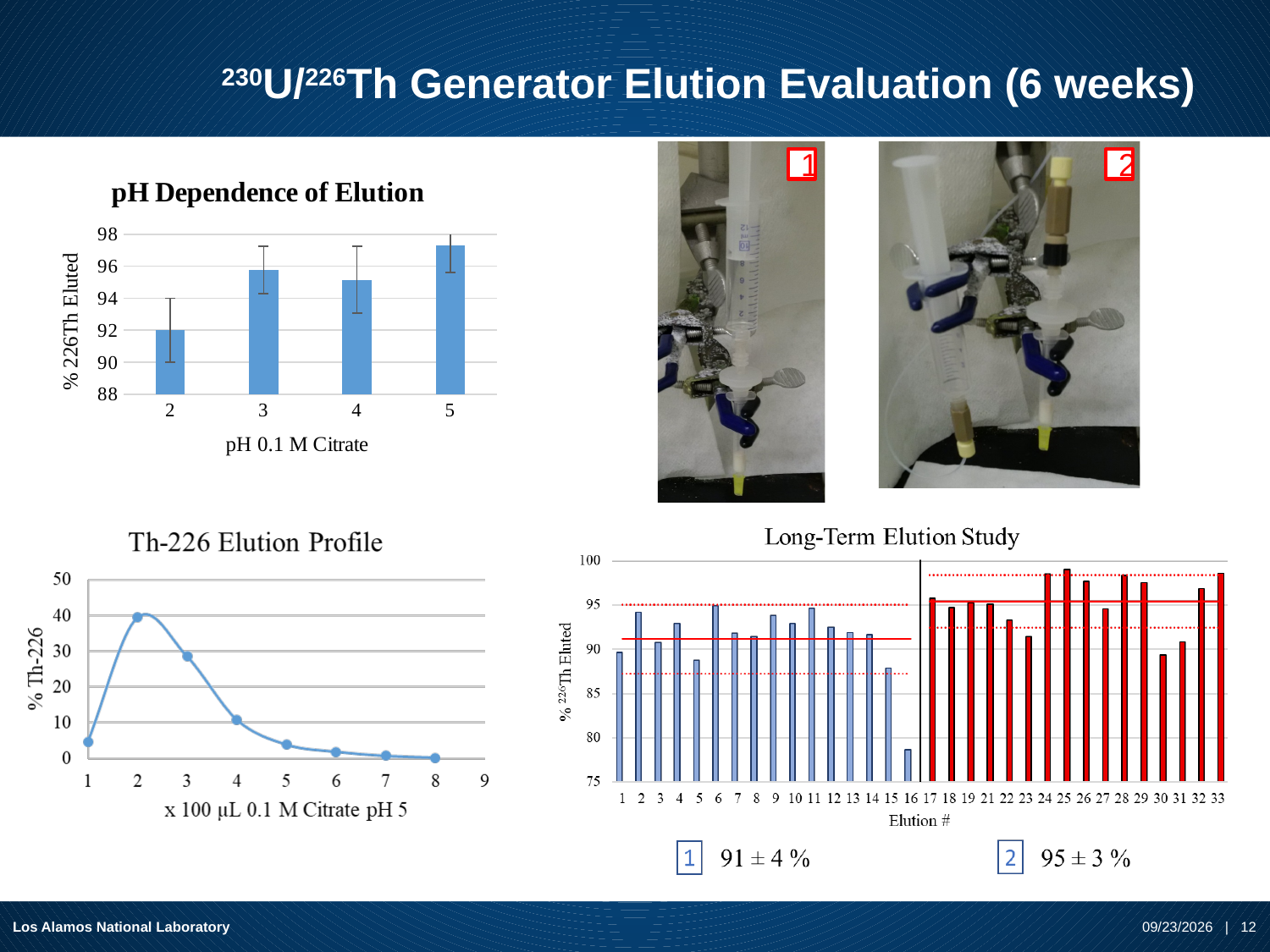
How many pH categories are plotted on the 'pH Dependence of Elution' chart? 4 On the 'Long-Term Elution Study' chart, which elution number has the lowest % 226Th eluted? 16 On the 'Long-Term Elution Study' chart, what colour are the bars for elutions 17 through 33? red What kind of chart is the 'Th-226 Elution Profile'? line chart On the 'pH Dependence of Elution' chart, is the value for pH 2 greater or less than 94? less On the 'pH Dependence of Elution' chart, is the value for pH 5 greater or less than 96? greater On the 'Long-Term Elution Study' chart, is the value for elution 16 greater or less than 80? less On the 'pH Dependence of Elution' chart, which pH has the lowest % 226Th eluted? 2 On the 'pH Dependence of Elution' chart, which pH has the highest % 226Th eluted? 5 On the 'Th-226 Elution Profile' chart, do the values rise or fall from x = 2 to x = 8? fall On the 'Th-226 Elution Profile' chart, at which x value (x 100 µL) does % Th-226 peak? 2